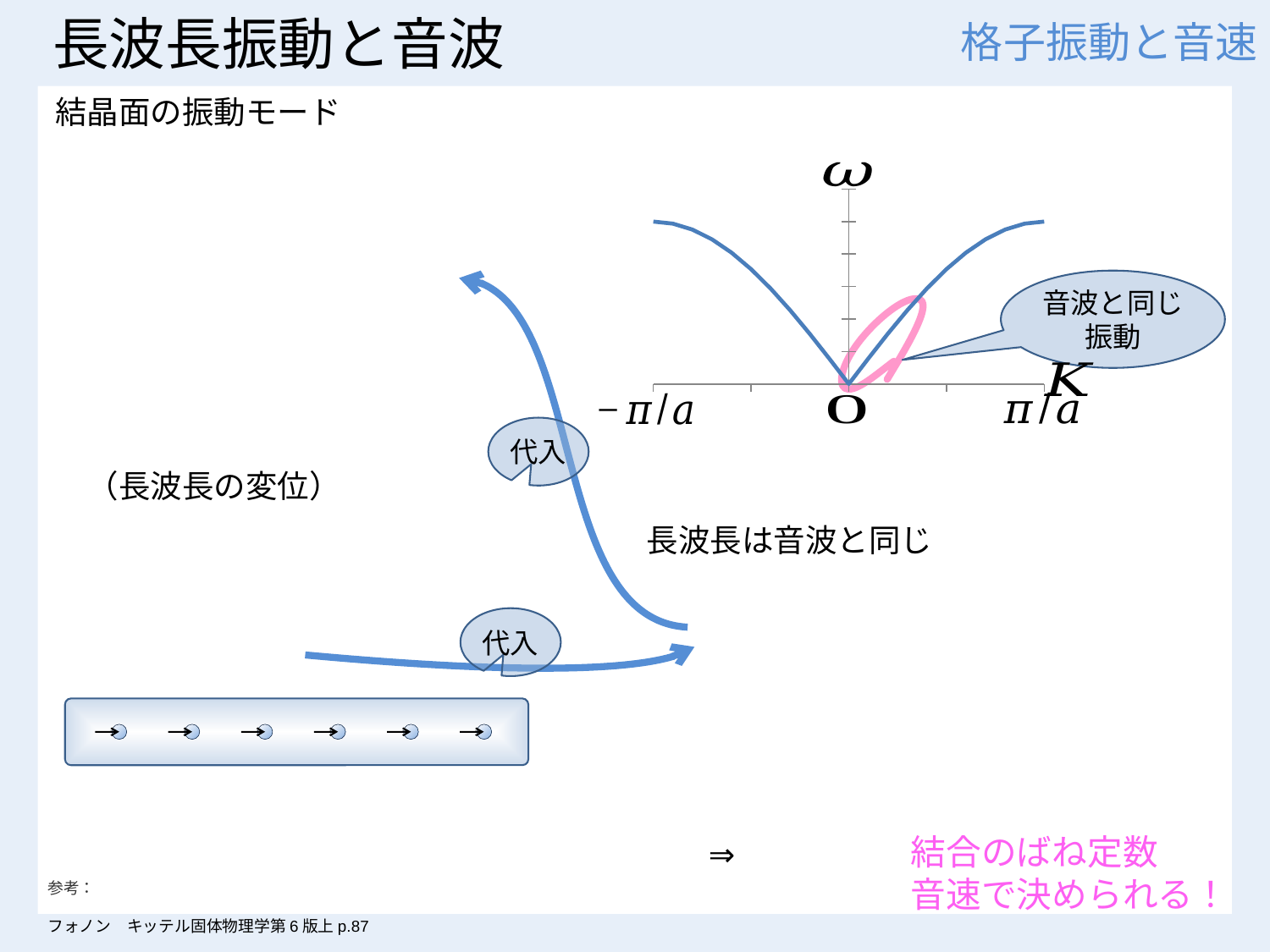
What kind of chart is shown on the slide? line chart How many labelled tick marks are on the horizontal axis of the chart? 3 What label is on the horizontal axis of the chart? K What label is on the vertical axis of the chart? ω Does ω rise or fall as K increases from O toward π/a? rise Is the value of ω at K = π/a greater or less than the value at K = O? greater At which horizontal-axis label does the curve reach its lowest value? O Does ω rise or fall as K increases from -π/a toward O? fall